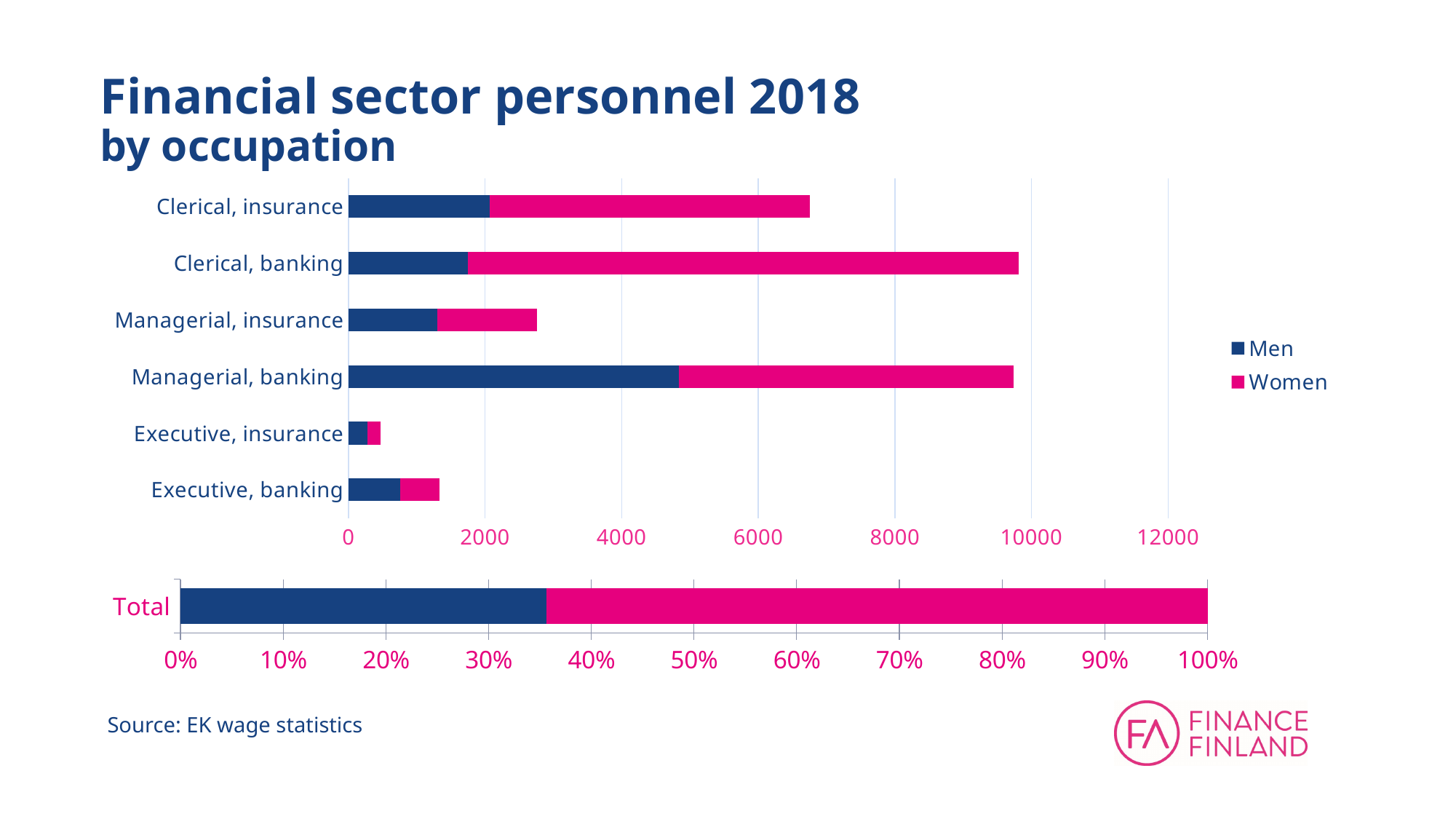
How many occupation categories does the top chart show? 6 In the bottom Total chart, is the share of men greater or less than 40%? less In the top chart, which occupation category has the largest number of women? Clerical, banking Which colour represents Women in the charts? pink How many series does the legend list? 2 In the top chart, which has more total personnel: Clerical, insurance or Managerial, insurance? Clerical, insurance In the top chart, which occupation category has the largest number of men? Managerial, banking What kind of chart is the top chart on the slide? bar chart In the top chart, which occupation category has the lowest total personnel? Executive, insurance In the top chart, is the total personnel for Managerial, insurance greater or less than 2000? greater In the top chart, is the total personnel for Clerical, insurance greater or less than 8000? less